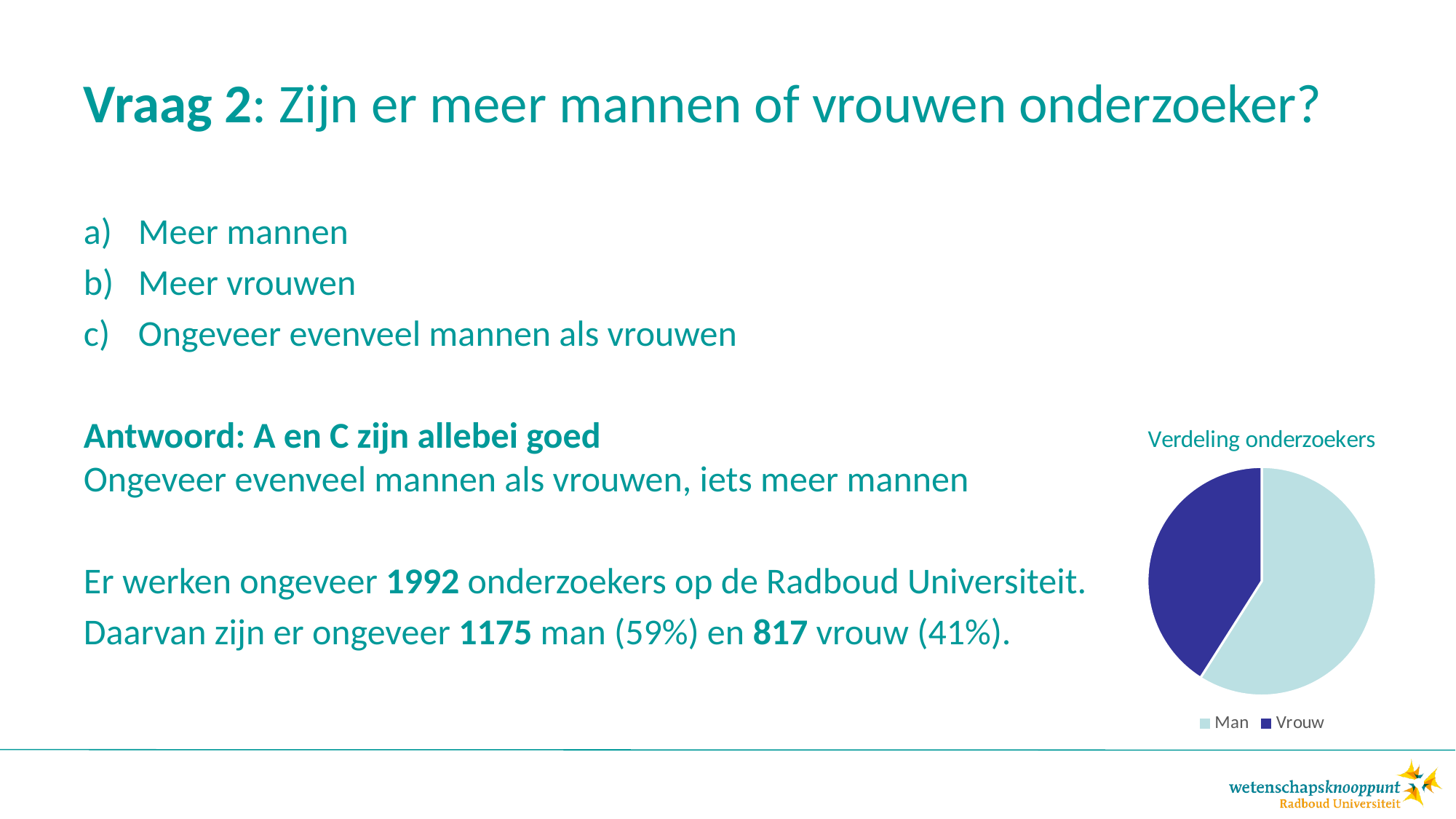
How many slices does the pie chart have? 2 Which is larger in the pie chart, the Man slice or the Vrouw slice? Man What share of the pie chart does the Vrouw slice represent, according to the slide? 41% Which slice of the pie chart is the smallest? Vrouw What kind of chart is shown on the slide? pie chart Which slice of the pie chart is the largest? Man What is the title of the pie chart? Verdeling onderzoekers What share of the pie chart does the Man slice represent, according to the slide? 59% According to the slide, how many researchers are men (Man)? 1175 How many entries does the legend of the pie chart list? 2 Which colour represents Vrouw in the pie chart? dark blue According to the slide, how many researchers are women (Vrouw)? 817